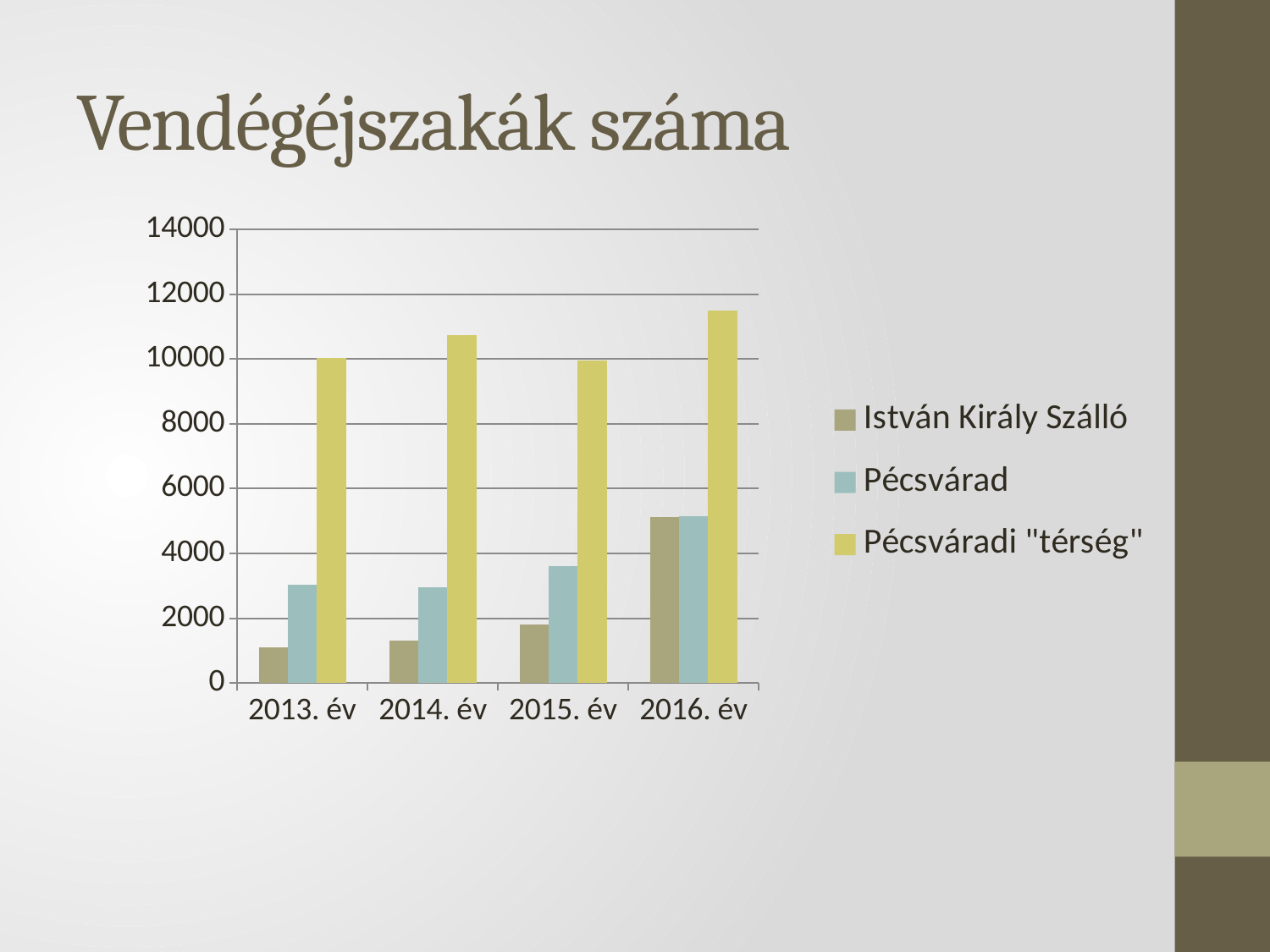
In which year is the Pécsváradi "térség" bar the highest? 2016. év Do the values for István Király Szálló rise or fall from 2013. év to 2016. év? rise Is the value for Pécsvárad in 2013. év greater or less than 2000? greater How many series does the legend list? 3 How many years are shown on the x axis? 4 Is the value for Pécsváradi "térség" in 2016. év greater or less than 10000? greater What is the title of the chart? Vendégéjszakák száma Is the value for István Király Szálló in 2016. év greater or less than 4000? greater In which year is the István Király Szálló bar the lowest? 2013. év What kind of chart is shown on the slide? bar chart In 2015. év, which is larger: the value for Pécsvárad or the value for István Király Szálló? Pécsvárad